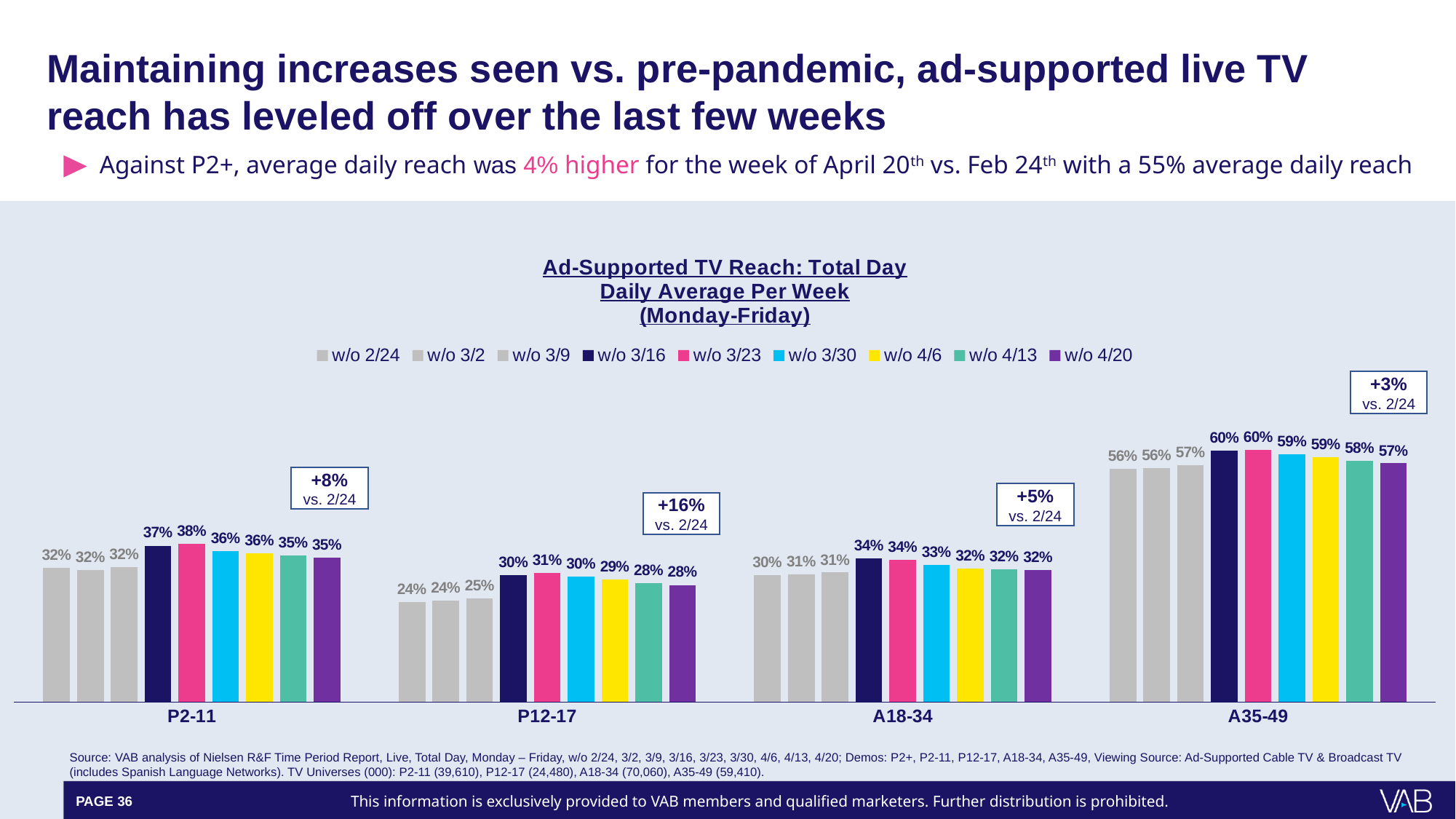
Which is larger for P2-11: the w/o 3/16 value or the w/o 4/20 value? w/o 3/16 What is the value for P2-11 in the w/o 3/23 series? 38% How many demo categories are shown on the x axis? 4 Which demo has the highest reach in the w/o 4/20 series? A35-49 What percentage change vs. 2/24 is annotated above the P12-17 group? +16% What kind of chart is shown? Bar chart What is the value for A18-34 in the w/o 4/20 series? 32% Which demo has the lowest reach in the w/o 2/24 series? P12-17 What is the value for P12-17 in the w/o 2/24 series? 24% What is the value for A35-49 in the w/o 3/16 series? 60% How many series does the legend list? 9 What is the difference between the w/o 3/23 and w/o 2/24 values for P12-17? 7%